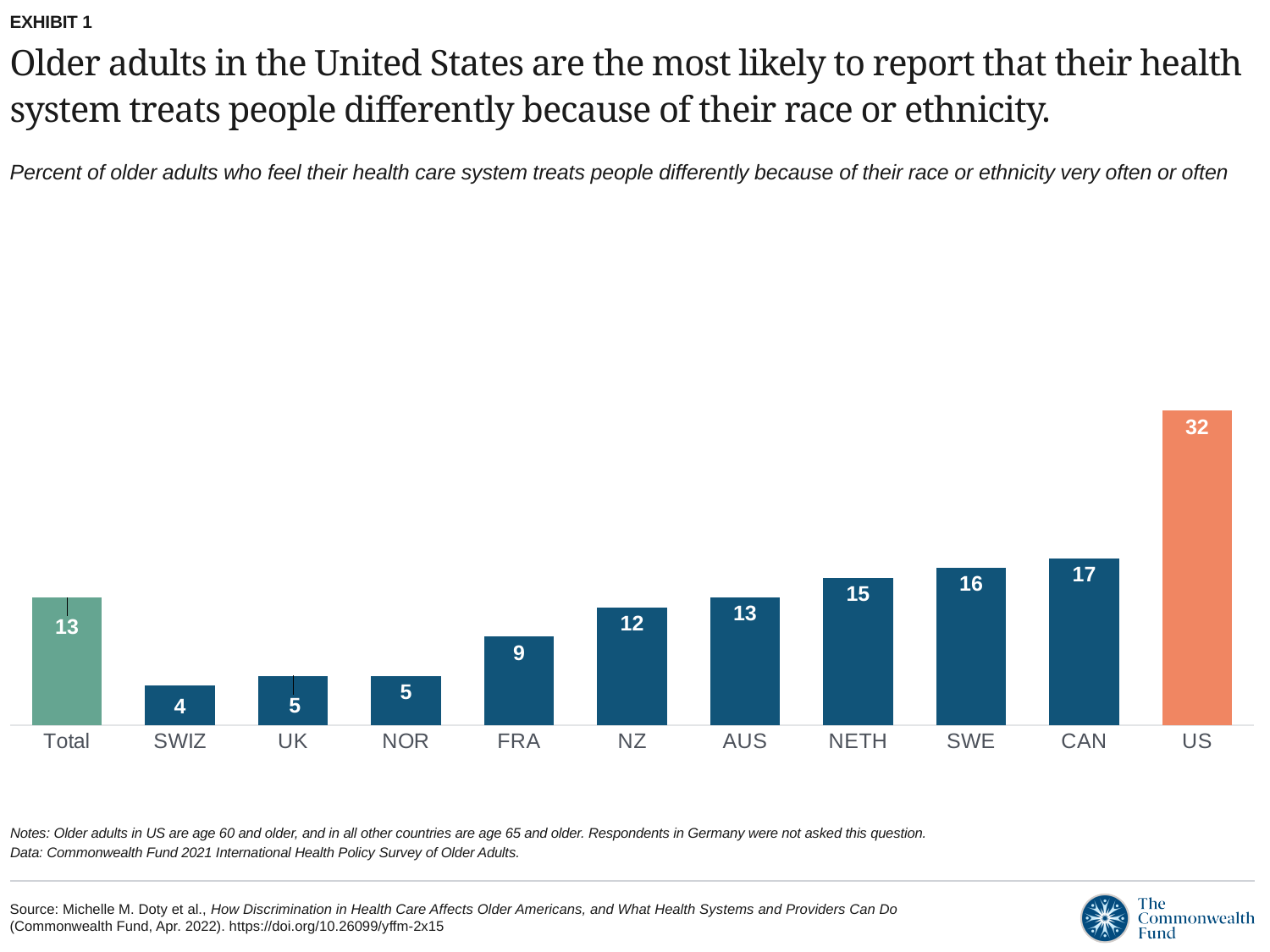
What is the difference between the values for NETH and NOR? 10 What is the value for the US? 32 Which country has the highest value? US What is the difference between the values for the US and CAN? 15 Which bar is coloured orange? US Which country has the lowest value? SWIZ Do the country values rise or fall from SWIZ to US along the x axis? rise What is the value for FRA? 9 What is the value for the Total bar? 13 How many bars are shown in the chart? 11 What kind of chart is shown on the slide? bar chart Which has a larger value, SWE or NZ? SWE